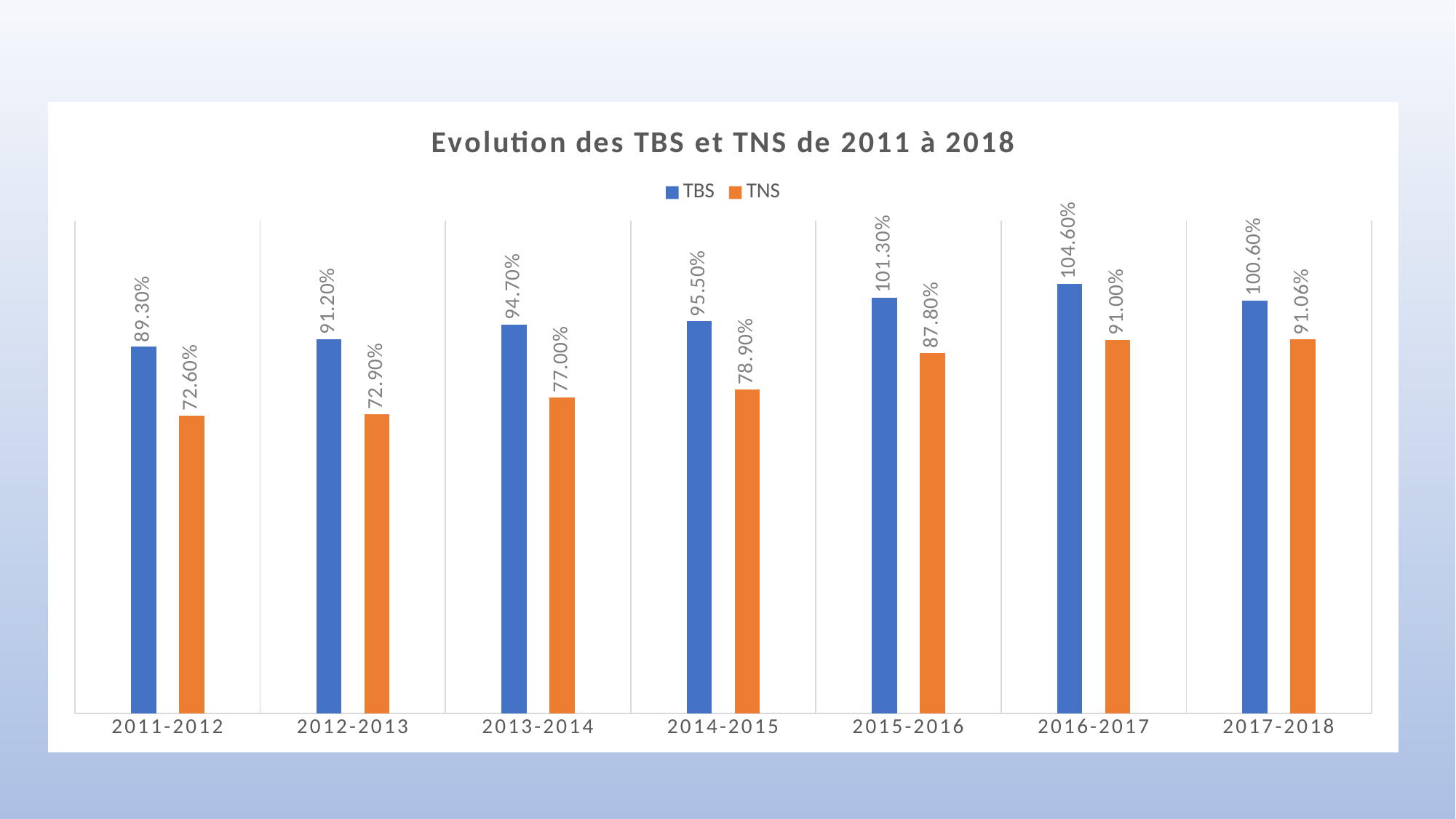
What is the TNS value for 2017-2018? 91.06% What kind of chart is shown on the slide? Bar chart What is the title of the chart? Evolution des TBS et TNS de 2011 à 2018 What is the TNS value for 2015-2016? 87.80% Which year has the highest TBS value? 2016-2017 How many year categories are shown on the x axis? 7 Which is larger, the TNS value for 2013-2014 or the TNS value for 2012-2013? 2013-2014 What is the TBS value for 2011-2012? 89.30% Which year has the lowest TNS value? 2011-2012 Does the TNS value rise or fall from 2011-2012 to 2016-2017? Rise How many series does the legend list? 2 What is the difference between the TBS and TNS values in 2014-2015? 16.60%